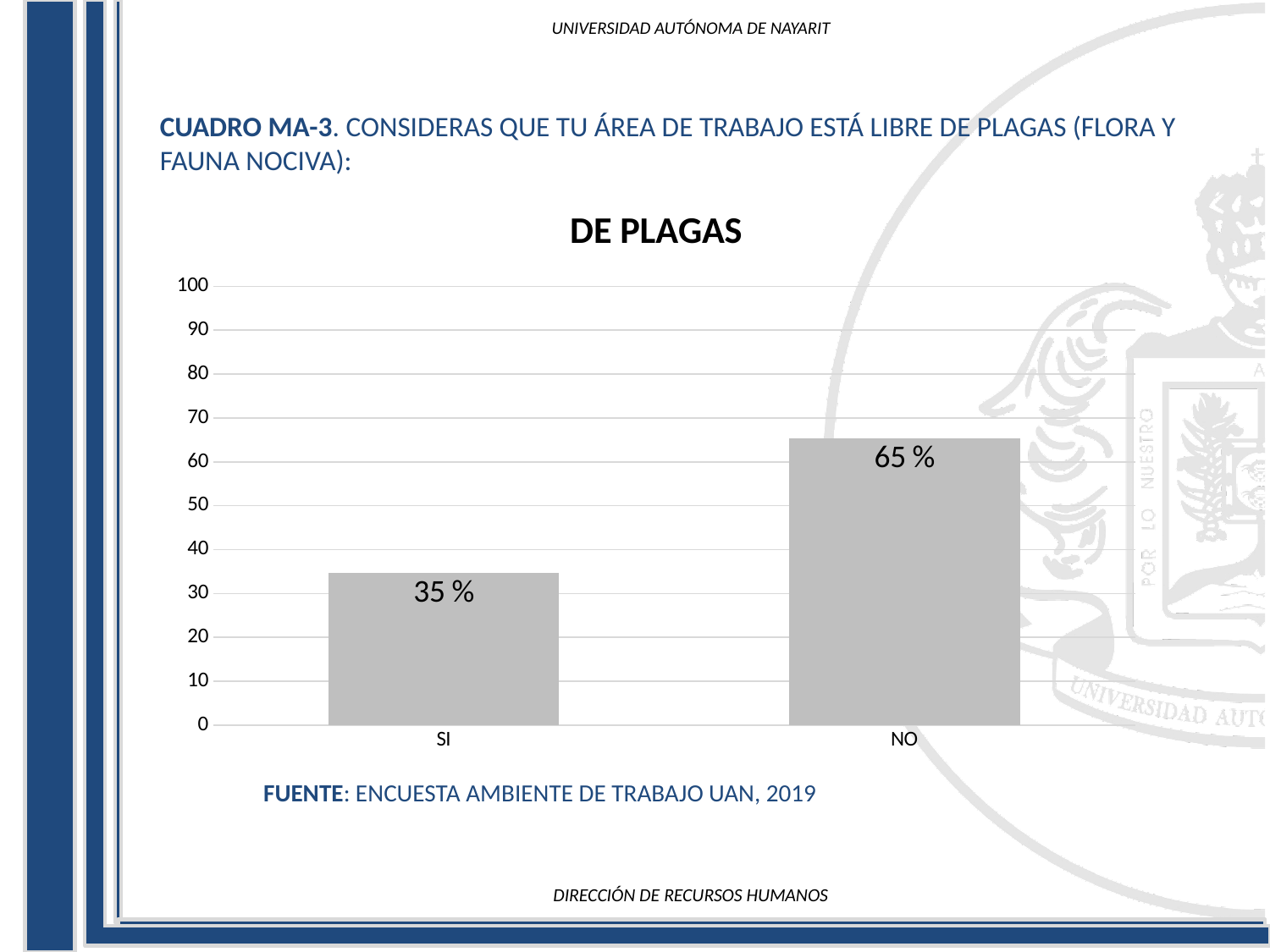
What is the title of the chart? DE PLAGAS What is the highest value shown on the y axis? 100 Which category has the highest value? NO Is the value for SI greater or less than 40? less Which is larger, the value for SI or the value for NO? NO How many categories are shown on the x axis? 2 Is the value for NO greater or less than 50? greater What is the difference between the values for NO and SI? 30 % What is the value for SI? 35 % What is the value for NO? 65 % What kind of chart is shown on the slide? bar chart Which category has the lowest value? SI